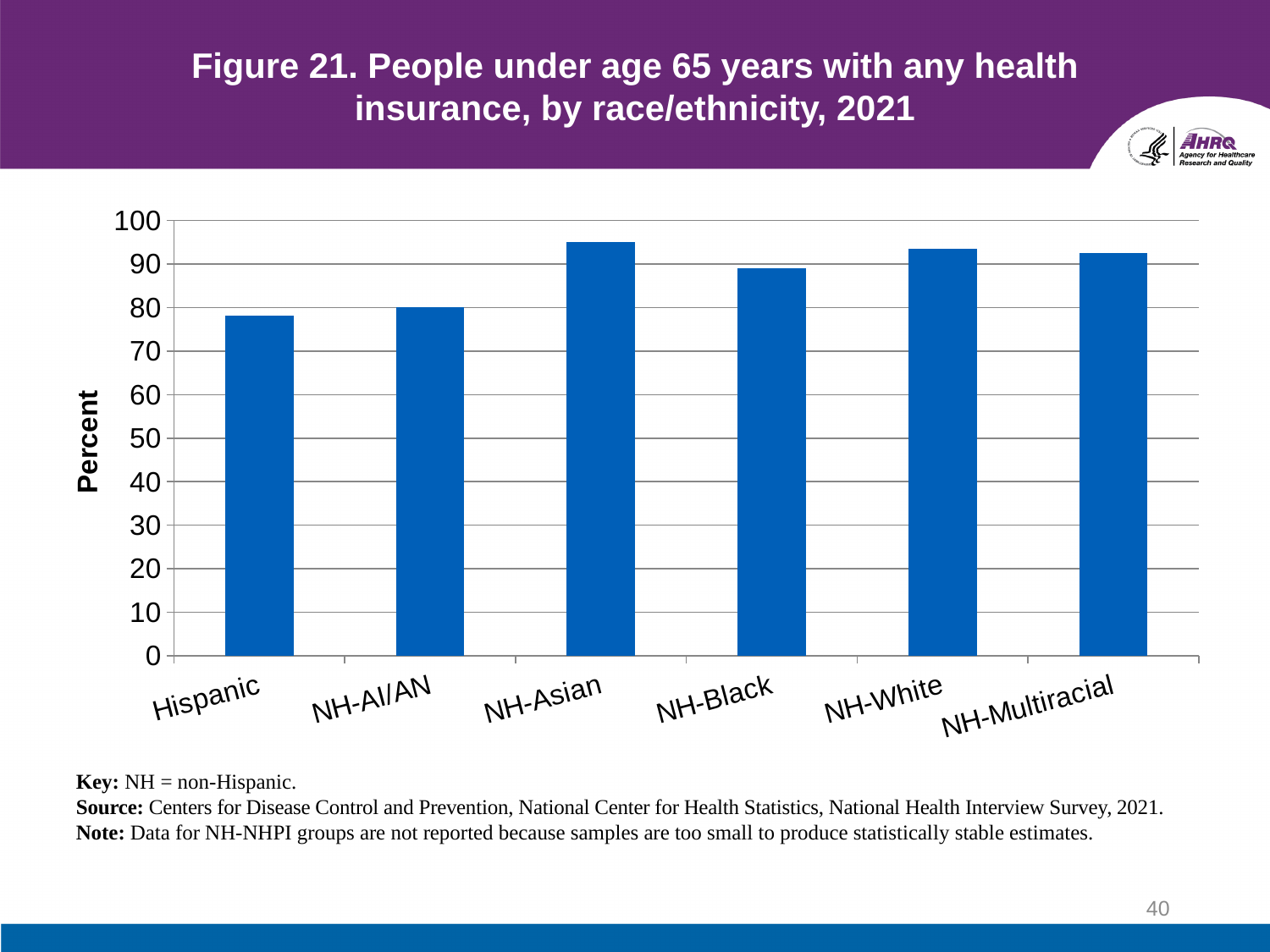
Is the value for NH-Black greater or less than 80? greater Is the value for NH-White greater or less than 90? greater Which is larger, the value for NH-Asian or the value for NH-Black? NH-Asian Which is larger, the value for NH-White or the value for Hispanic? NH-White What is the label on the vertical axis of the chart? Percent Which race/ethnicity group has the highest percentage of people under age 65 with any health insurance? NH-Asian What kind of chart is shown on the slide? Bar chart Which race/ethnicity group has the lowest percentage of people under age 65 with any health insurance? Hispanic Is the value for NH-Asian greater or less than 90? greater How many race/ethnicity categories are plotted on the chart? 6